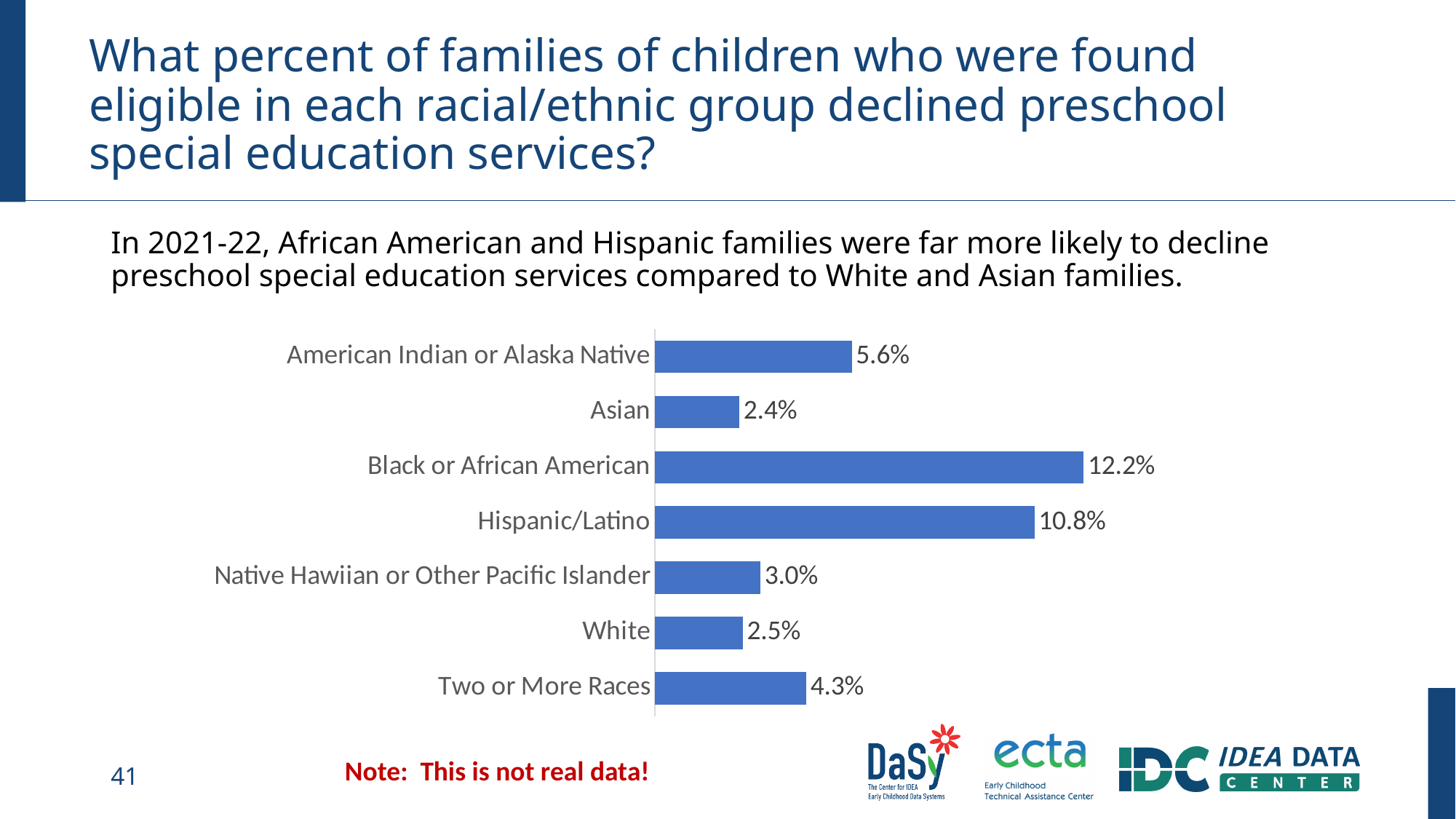
What kind of chart is shown on the slide? Bar chart What is the value for Two or More Races? 4.3% What is the value for American Indian or Alaska Native? 5.6% Which racial/ethnic group has the lowest value? Asian Which racial/ethnic group has the highest value? Black or African American What is the value for Hispanic/Latino? 10.8% Which is larger, the value for Native Hawiian or Other Pacific Islander or the value for Two or More Races? Two or More Races How many racial/ethnic groups are shown in the chart? 7 What is the difference between the values for American Indian or Alaska Native and White? 3.1% What is the value for Black or African American? 12.2% What colour are the bars in the chart? Blue What is the difference between the values for Black or African American and Hispanic/Latino? 1.4%